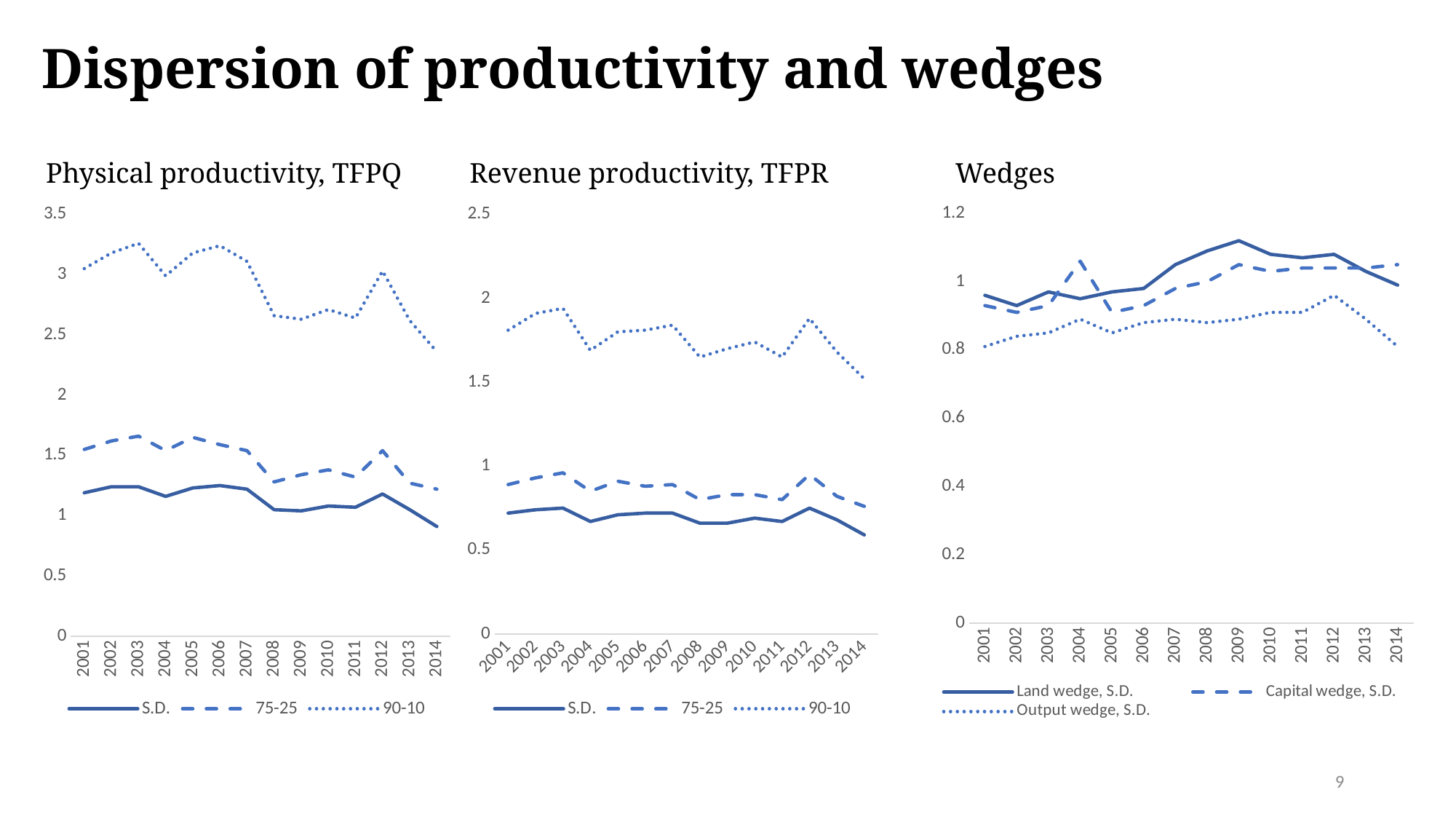
In the Physical productivity, TFPQ chart, which series has the highest values throughout the period? 90-10 In the Revenue productivity, TFPR chart, is the 90-10 value for 2003 greater or less than 1.5? greater In the Wedges chart, is the Capital wedge, S.D. value for 2004 greater or less than 1? greater In the Revenue productivity, TFPR chart, which is larger in 2012, the 75-25 value or the S.D. value? 75-25 In the Physical productivity, TFPQ chart, is the 90-10 value for 2003 greater or less than 3? greater How many years are plotted on the x axis of the Revenue productivity, TFPR chart? 14 In the Physical productivity, TFPQ chart, does the 90-10 series overall rise or fall from 2001 to 2014? fall In the Wedges chart, which series is drawn with a dotted line? Output wedge, S.D. How many series does the legend of the Wedges chart list? 3 What kind of chart is the Physical productivity, TFPQ chart? line chart In the Wedges chart, in which year does the Land wedge, S.D. series reach its highest value? 2009